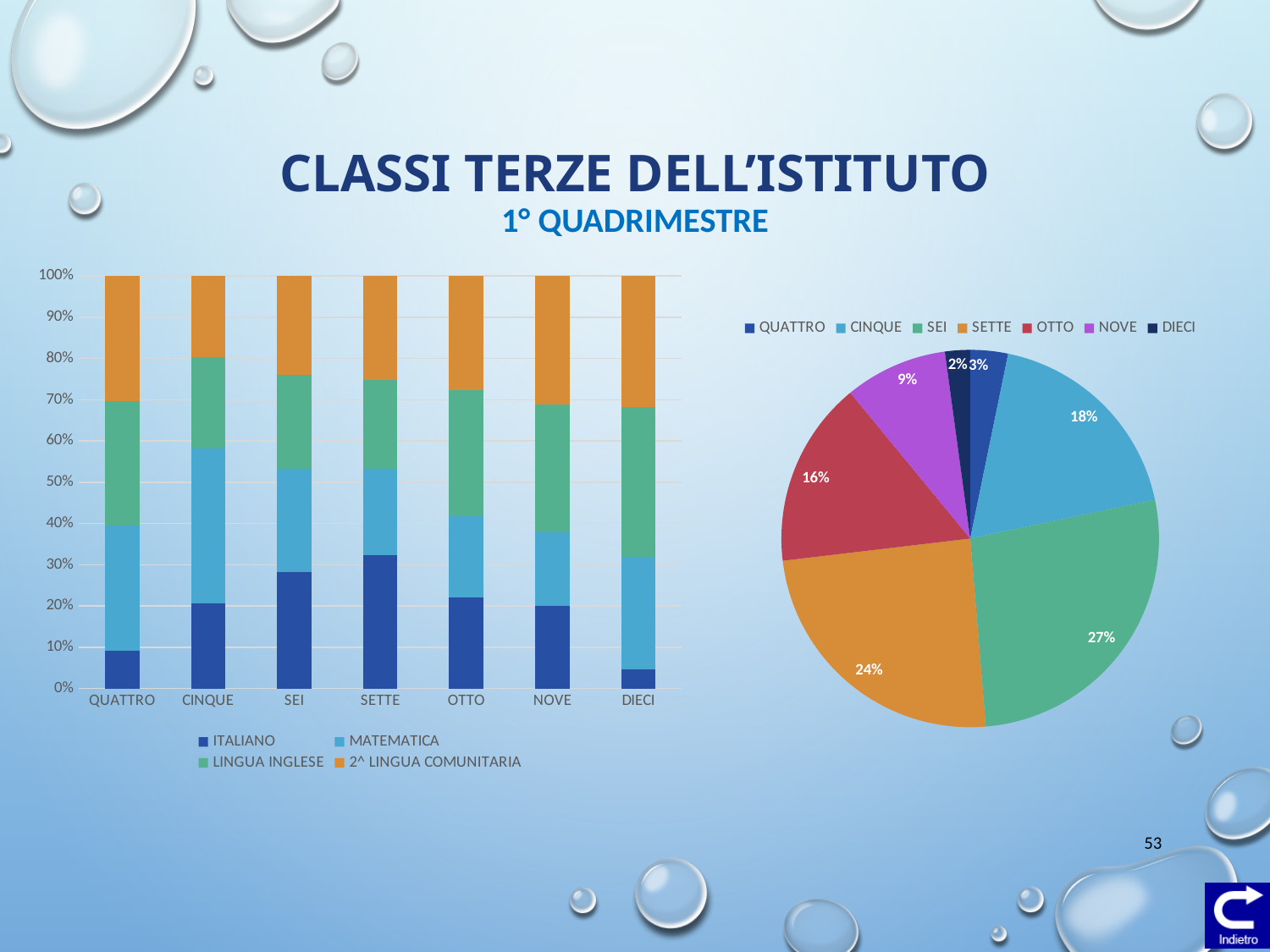
How many series does the legend of the bar chart on the left list? 4 What kind of chart is the chart on the left of the slide? bar chart In the pie chart on the right, what share does SEI have? 27% In the bar chart on the left, which category has the largest ITALIANO segment? SETTE How many categories are shown on the x axis of the bar chart on the left? 7 In the pie chart on the right, which category has the largest slice? SEI In the pie chart on the right, what share does OTTO have? 16% In the bar chart on the left, is the ITALIANO value for DIECI greater or less than 10%? less What kind of chart is the chart on the right of the slide? pie chart In the pie chart on the right, which is larger, the share for CINQUE or the share for NOVE? CINQUE In the pie chart on the right, what is the difference between the SEI and SETTE shares? 3 percentage points In the bar chart on the left, is the ITALIANO value for SETTE greater or less than 30%? greater